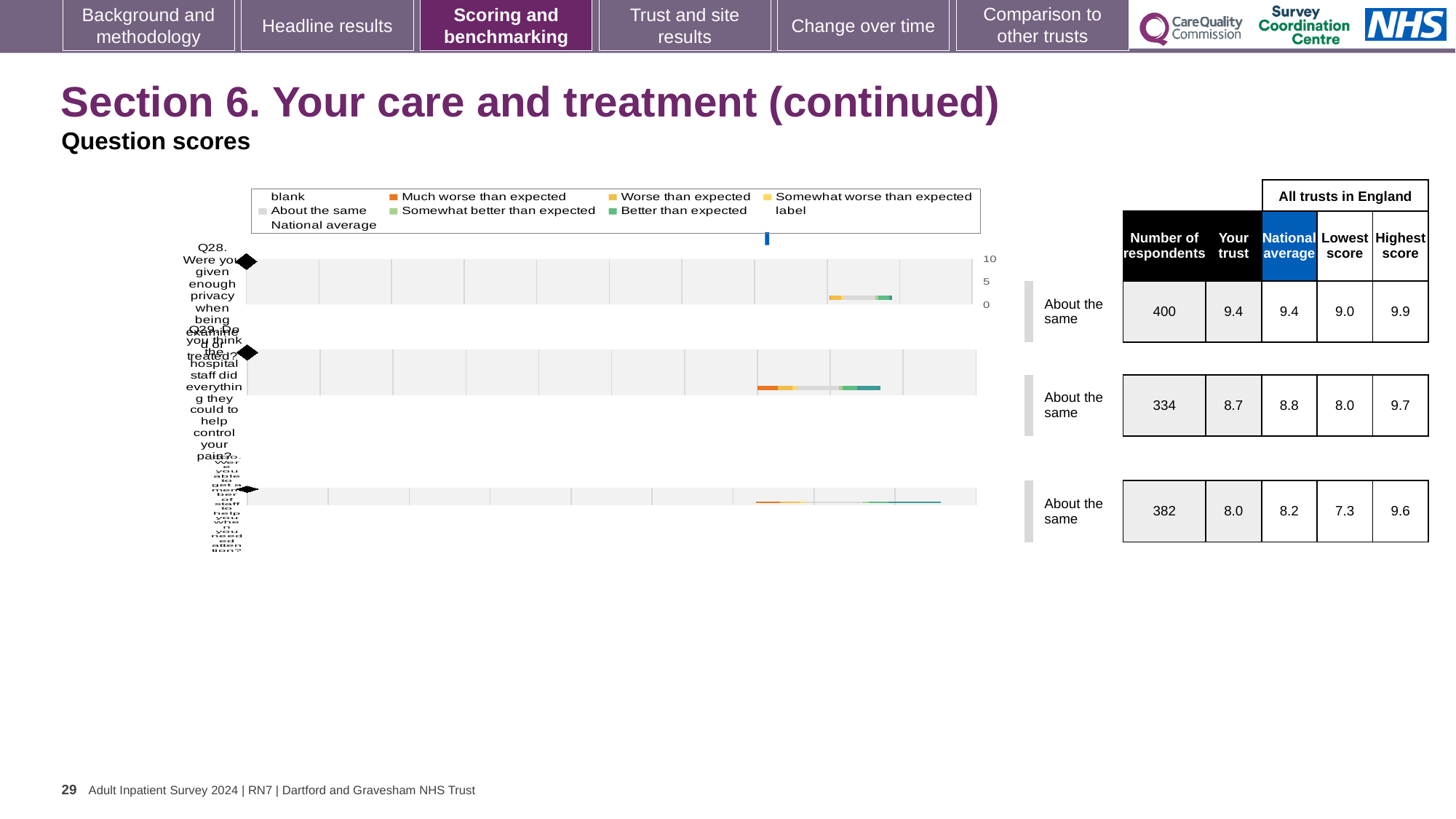
What is the difference between the highest score and the lowest score for Q30 in the table? 2.3 In the table next to the chart, what is the 'Your trust' score for Q28 (privacy when being examined or treated)? 9.4 What is the difference in number of respondents between Q28 and Q29? 66 How many entries does the chart legend list? 9 What kind of chart is shown on the slide? Bar chart Which question has the highest 'Your trust' score in the table? Q28 Which question has the lowest 'Lowest score' value in the table? Q30 In the table next to the chart, what is the national average for Q29 (staff did everything to help control your pain)? 8.8 In the table next to the chart, how many respondents are listed for Q30? 382 How many questions (rows) are plotted in the chart? 3 For Q29, which is larger: the 'Your trust' score or the national average? National average What benchmark category is shown beside the chart for Q28? About the same